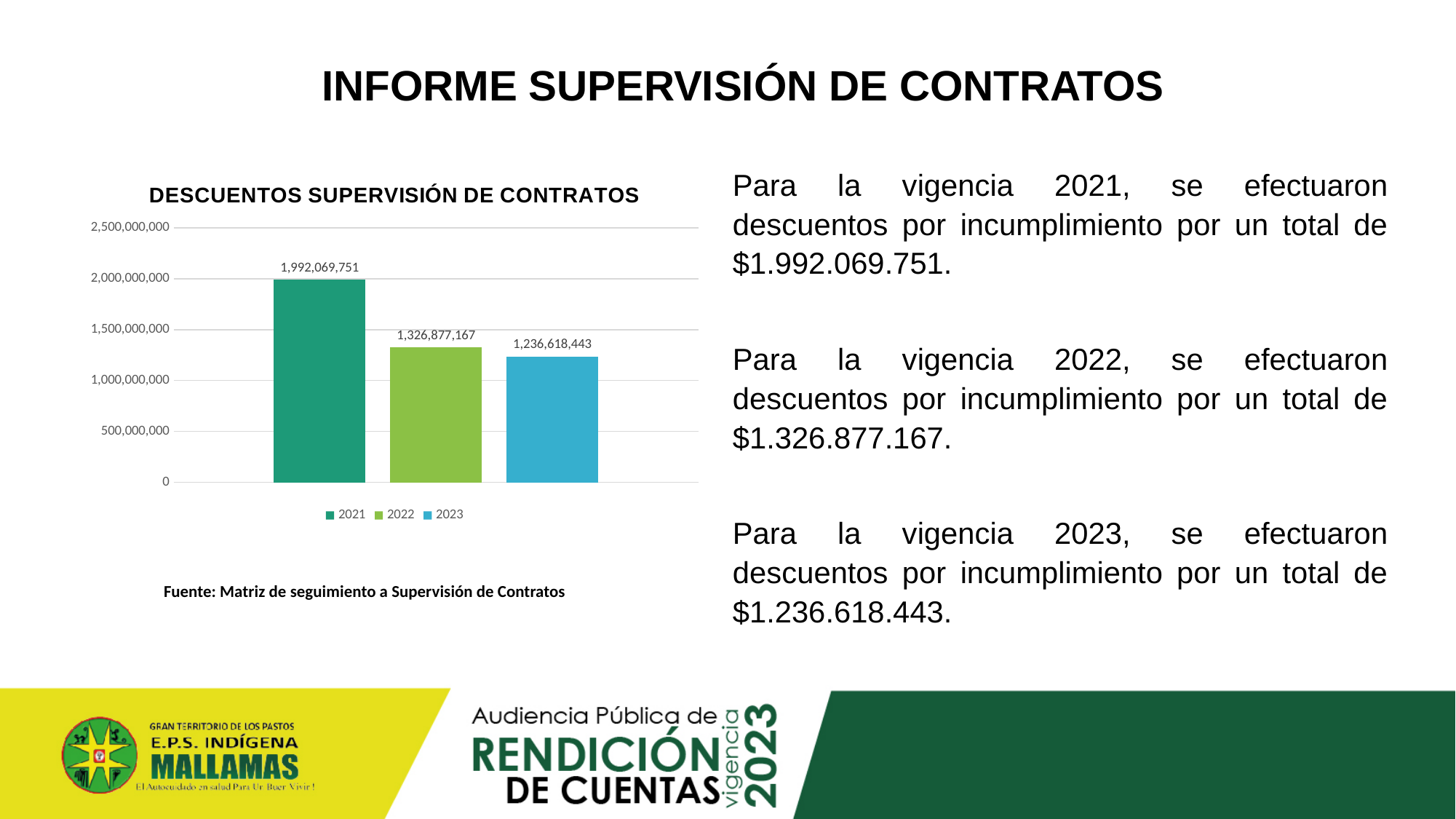
Which year has the highest value in the chart? 2021 How many bars are plotted in the chart? 3 Do the values rise or fall from 2021 to 2023? Fall What is the difference between the values for 2021 and 2022? 665,192,584 What is the value shown for 2023 in the chart? 1,236,618,443 What is the value shown for 2021 in the chart? 1,992,069,751 What kind of chart is shown on the slide? Bar chart Which is larger, the value for 2022 or the value for 2023? 2022 Is the value for 2021 greater or less than 1,500,000,000? greater What is the value shown for 2022 in the chart? 1,326,877,167 What is the difference between the values for 2022 and 2023? 90,258,724 Which year has the lowest value in the chart? 2023